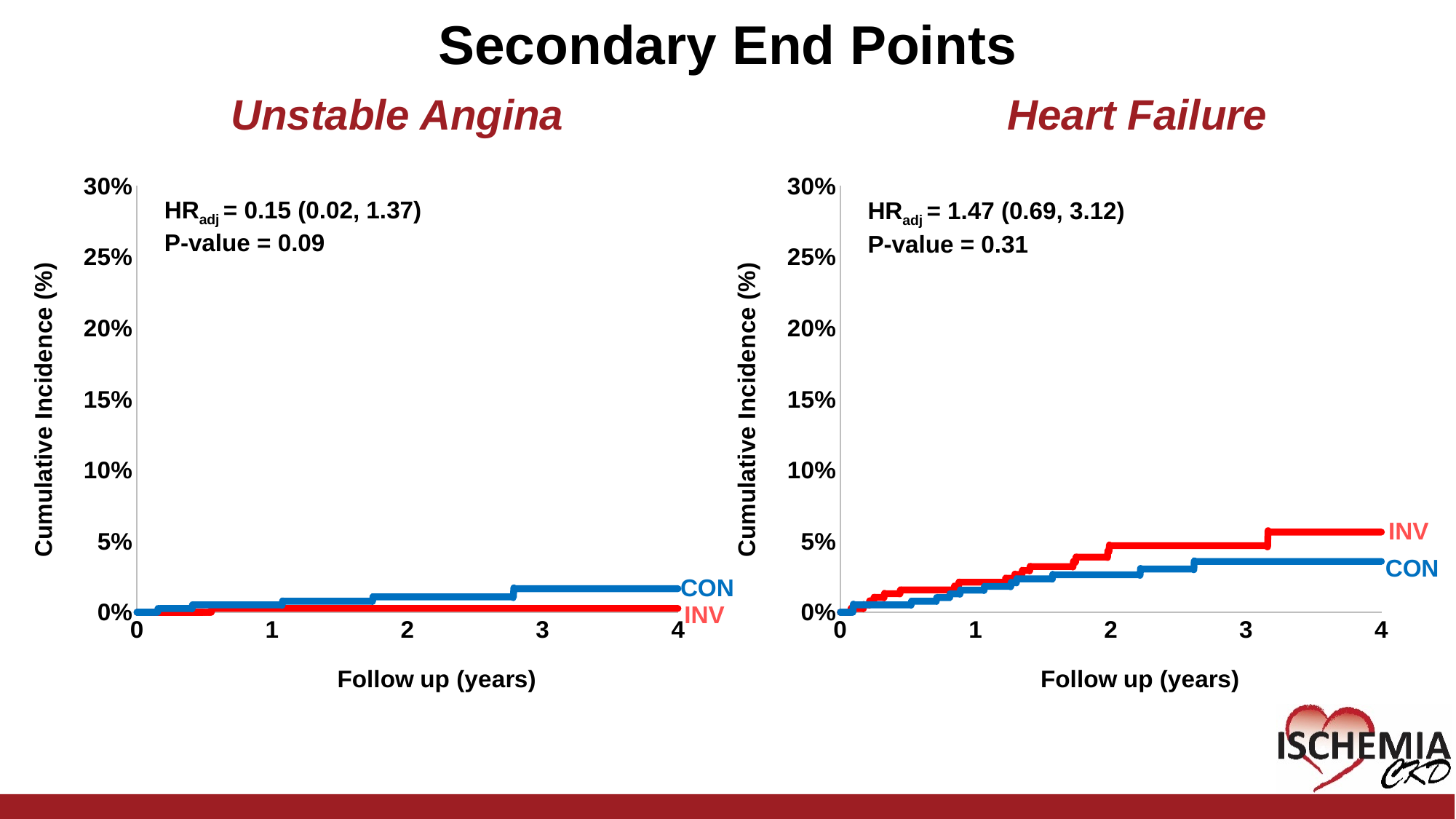
What is the x-axis label of the Unstable Angina chart? Follow up (years) On the Heart Failure chart, is the cumulative incidence for CON at 4 years greater or less than 5%? less On the Unstable Angina chart, is the cumulative incidence for CON at 4 years greater or less than 5%? less How many series are plotted on the Heart Failure chart? 2 What kind of chart is the Unstable Angina chart? line chart What is the adjusted hazard ratio shown on the Unstable Angina chart? 0.15 (0.02, 1.37) What P-value is shown on the Heart Failure chart? 0.31 What is the maximum value shown on the y axis of the Heart Failure chart? 30% On the Unstable Angina chart, which series is higher at 4 years of follow up, CON or INV? CON On the Heart Failure chart, does the cumulative incidence for INV rise or fall as follow up increases? rise On the Heart Failure chart, which series is higher at 4 years of follow up, CON or INV? INV